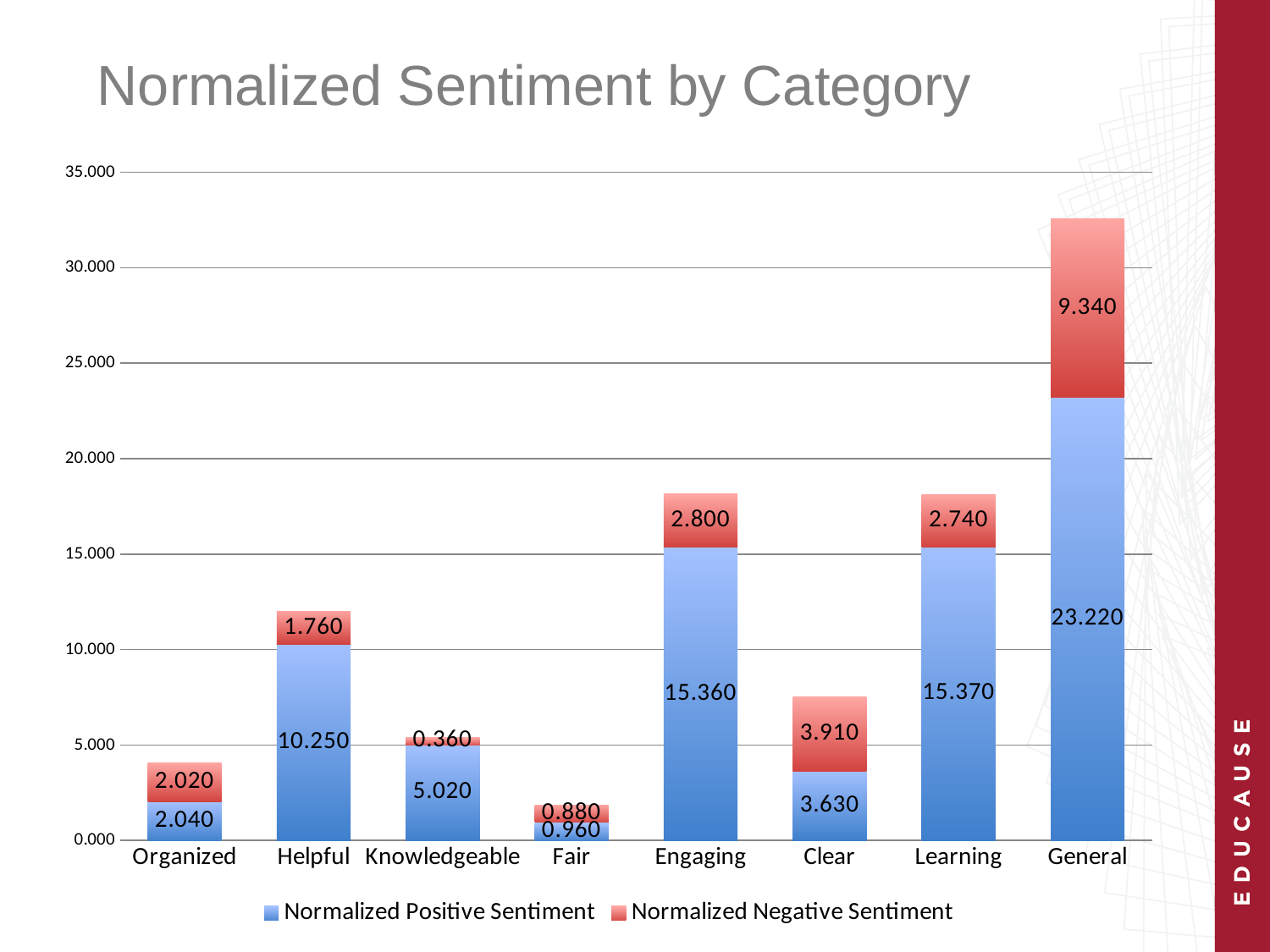
What is the Normalized Negative Sentiment value for General? 9.340 What is the Normalized Positive Sentiment value for Engaging? 15.360 What is the Normalized Positive Sentiment value for Helpful? 10.250 What is the difference between the Normalized Negative Sentiment for General and for Clear? 5.430 What is the total of the stacked bar for General? 32.560 Which category has the lowest Normalized Negative Sentiment? Knowledgeable Which category has the lowest Normalized Positive Sentiment? Fair Is the total stacked value for Helpful greater or less than 10.000? greater Which category has the highest Normalized Positive Sentiment? General How many series does the legend list? 2 For Clear, which is larger: Normalized Positive Sentiment or Normalized Negative Sentiment? Normalized Negative Sentiment How many categories are shown on the x axis? 8